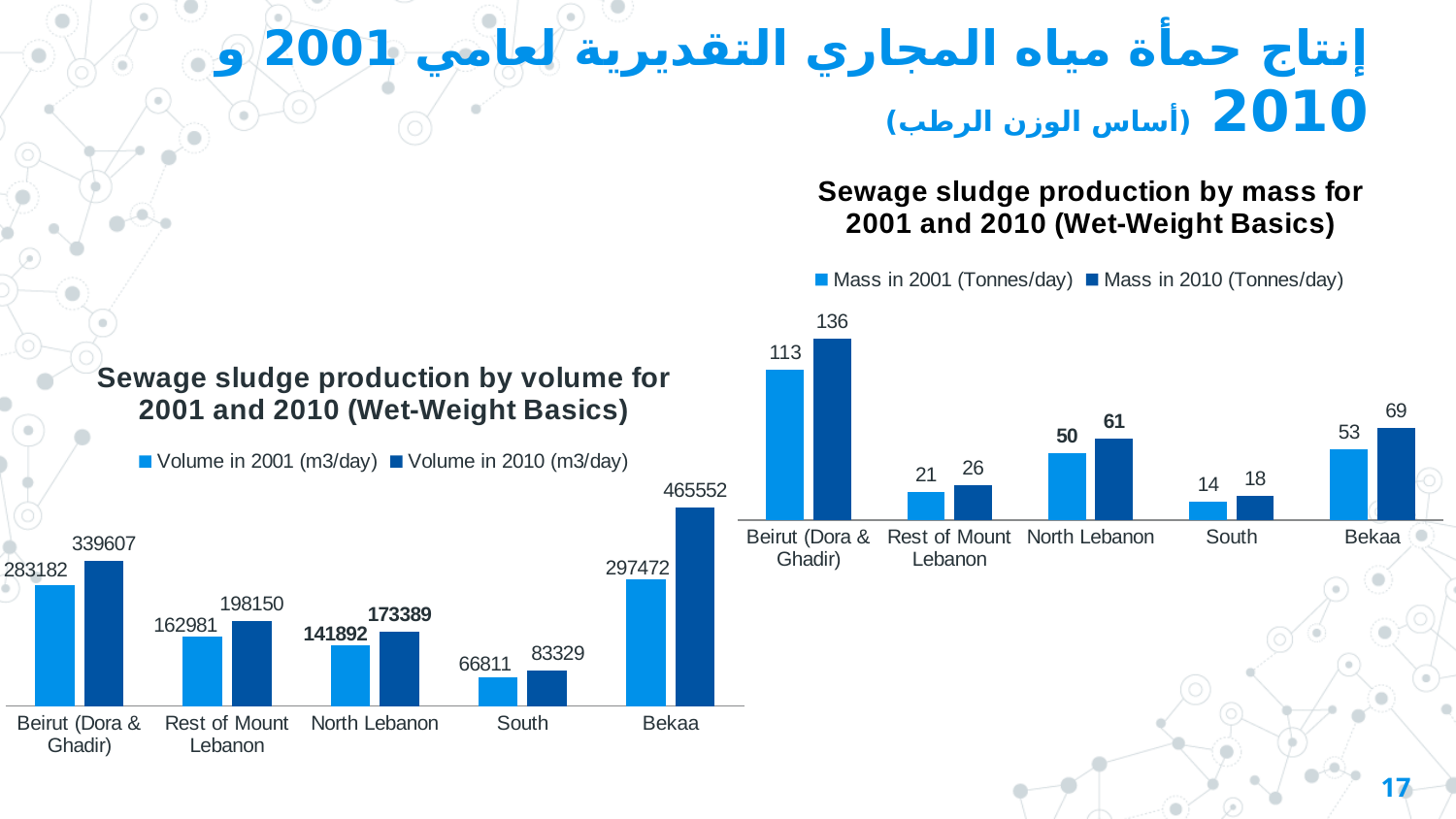
In the 'Sewage sludge production by mass' chart, which is larger: the Mass in 2001 for Bekaa or the Mass in 2001 for North Lebanon? Bekaa In the 'Sewage sludge production by mass' chart, what is the Mass in 2010 (Tonnes/day) for Beirut (Dora & Ghadir)? 136 In the 'Sewage sludge production by mass' chart, what is the Mass in 2001 (Tonnes/day) for Bekaa? 53 In the 'Sewage sludge production by volume' chart, which region has the lowest Volume in 2001 (m3/day)? South In the 'Sewage sludge production by volume' chart, what is the difference between the 2010 and 2001 volumes for South? 16518 In the 'Sewage sludge production by volume' chart, how many regions are shown on the x axis? 5 How many series does the legend of the 'Sewage sludge production by mass' chart list? 2 In the 'Sewage sludge production by mass' chart, what is the difference between the Mass in 2010 and Mass in 2001 for North Lebanon? 11 In the 'Sewage sludge production by volume' chart, which region has the highest Volume in 2010 (m3/day)? Bekaa In the 'Sewage sludge production by volume' chart, what is the Volume in 2010 (m3/day) for Bekaa? 465552 In the 'Sewage sludge production by mass' chart, which region has the lowest Mass in 2010 (Tonnes/day)? South In the 'Sewage sludge production by volume' chart, what is the Volume in 2001 (m3/day) for North Lebanon? 141892